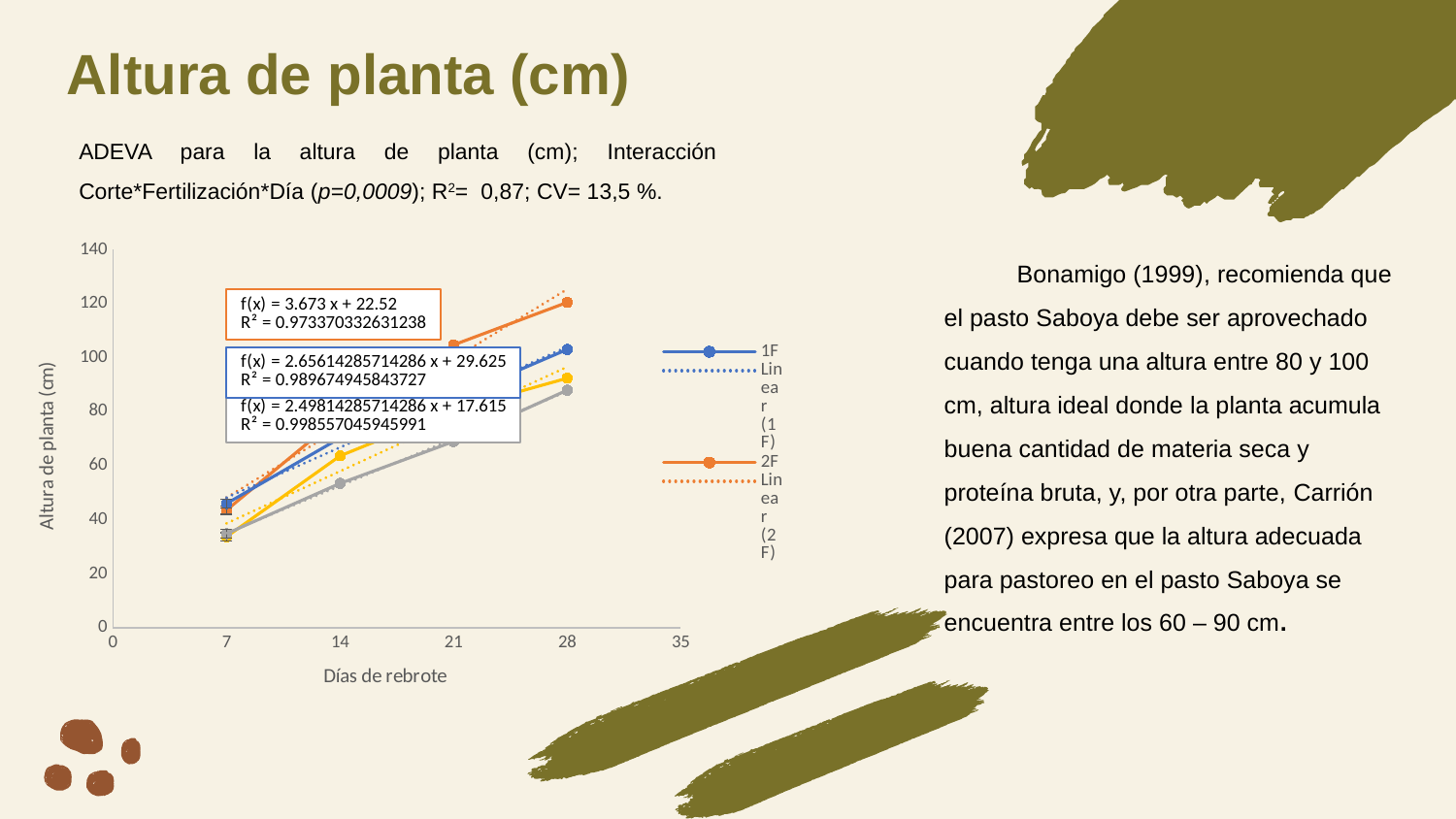
Is the value for the 2F series at day 28 greater or less than 100? greater What is the title of the y axis of the chart? Altura de planta (cm) What is the highest value shown on the x axis of the chart? 35 Do the plant height values rise or fall as the days of regrowth increase? rise Is the value for the 2F series at day 14 greater or less than 100? less What is the highest value shown on the y axis of the chart? 140 Is the value for the 1F series at day 7 greater or less than 60? less Which series reaches the highest plant height at day 28? 2F How many days of regrowth are plotted as data points on the x axis? 4 What kind of chart is shown on the slide? line chart What is the title of the x axis of the chart? Días de rebrote At day 28, which series has the larger value, 1F or 2F? 2F